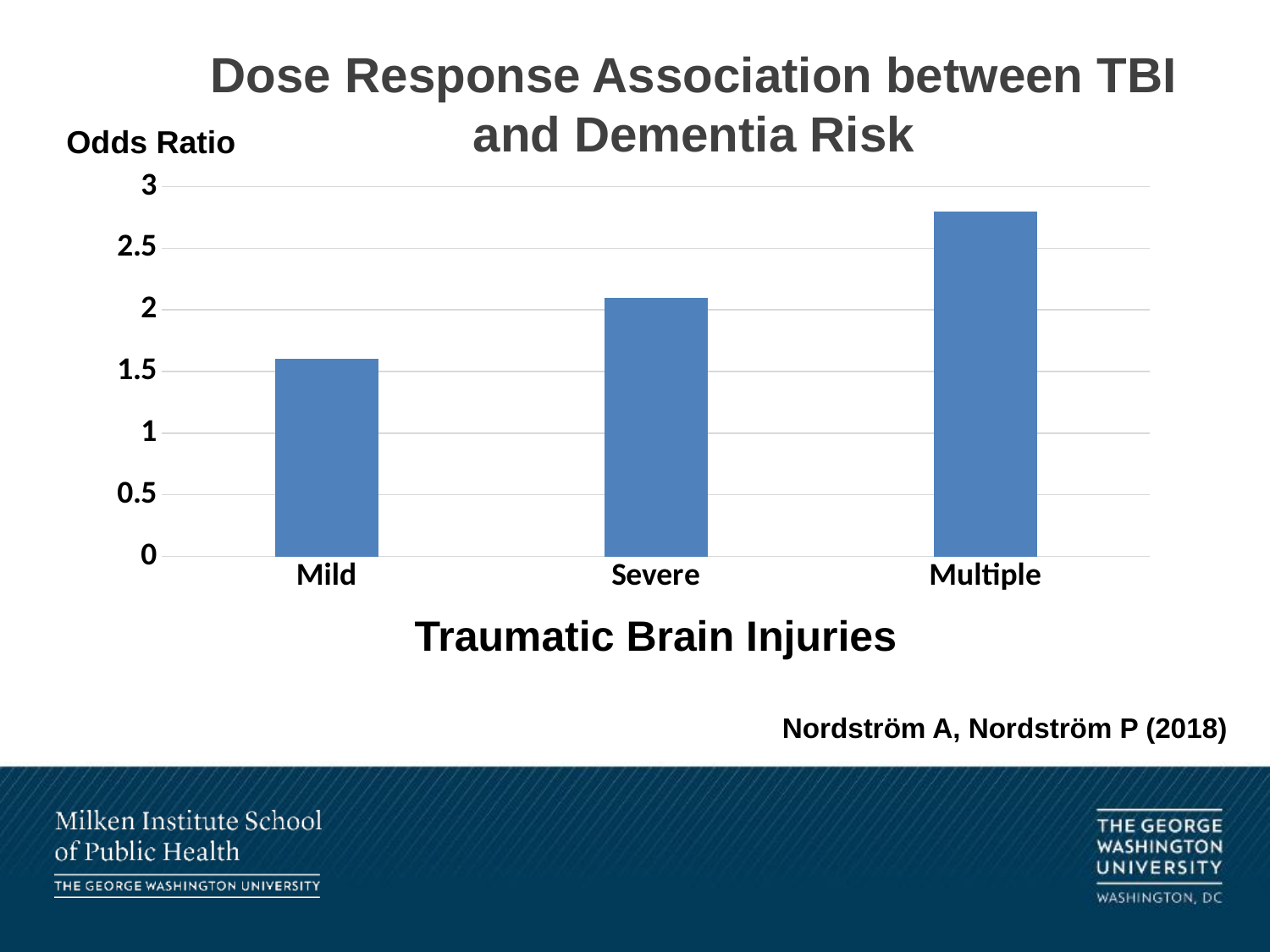
Which category has the highest odds ratio? Multiple Is the odds ratio for Mild greater or less than 1? greater Which has a larger odds ratio, Severe or Multiple? Multiple Which has a larger odds ratio, Mild or Severe? Severe Is the odds ratio for Severe greater or less than 2.5? less Do the odds ratios rise or fall moving from Mild to Severe to Multiple? rise How many categories of traumatic brain injury are shown on the x axis? 3 Is the odds ratio for Mild greater or less than 2? less What type of chart is shown on the slide? bar chart Which category has the lowest odds ratio? Mild What is the label of the x axis? Traumatic Brain Injuries